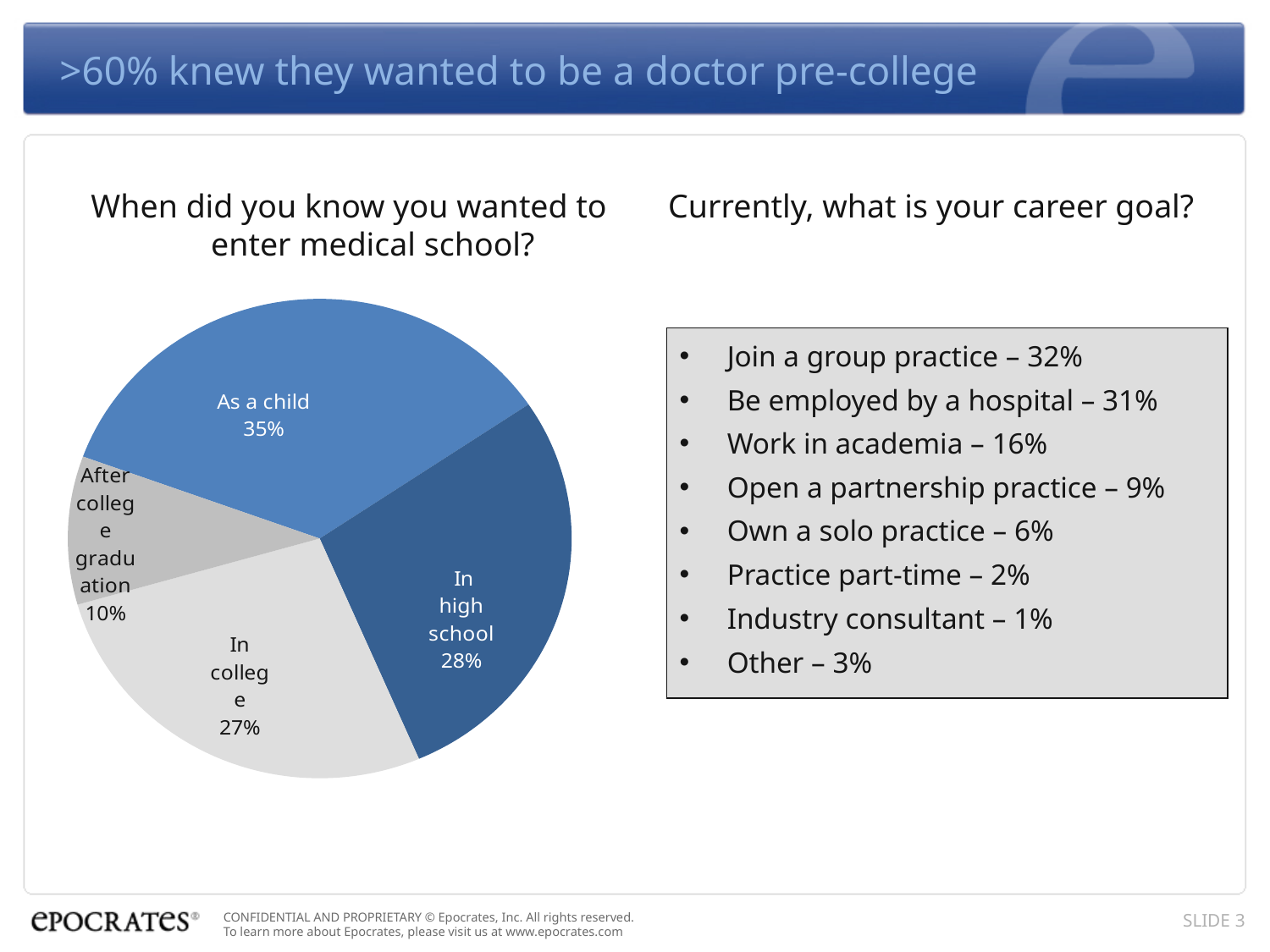
What is the title of the pie chart? When did you know you wanted to enter medical school? How many slices does the pie chart have? 4 Which is larger, 'As a child' or 'In college'? As a child What share of the pie is 'As a child'? 35% What is the difference between the 'As a child' and 'After college graduation' slices? 25% Which category has the smallest slice of the pie? After college graduation What is the value for 'In high school' in the pie chart? 28% What kind of chart is shown on the slide? pie chart What is the value for 'In college' in the pie chart? 27% What is the combined share of 'As a child' and 'In high school'? 63% What is the value for 'After college graduation' in the pie chart? 10% Which category has the largest slice of the pie? As a child